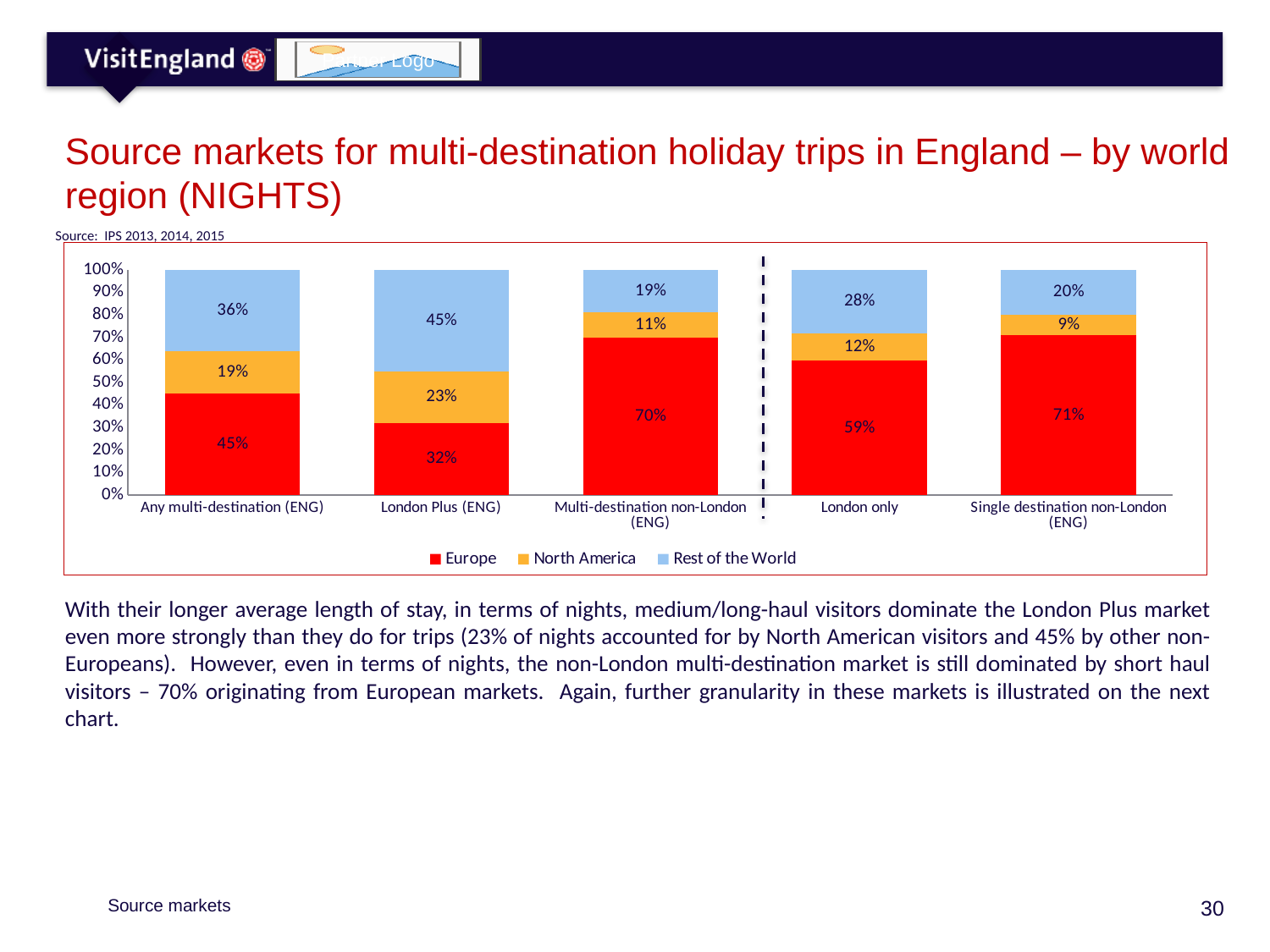
What is the Rest of the World share for London only? 28% How many series does the legend list? 3 Which category has the lowest Europe share? London Plus (ENG) What is the difference between the Europe share for Multi-destination non-London (ENG) and London Plus (ENG)? 38% What is the Europe share for London Plus (ENG)? 32% What is the Europe share for Single destination non-London (ENG)? 71% How many categories are shown on the x axis? 5 Which category has the highest Rest of the World share? London Plus (ENG) What is the North America share for Any multi-destination (ENG)? 19% Which is larger: the North America share for London only or for Single destination non-London (ENG)? London only What kind of chart is shown? Stacked bar chart Which category has the highest Europe share? Single destination non-London (ENG)